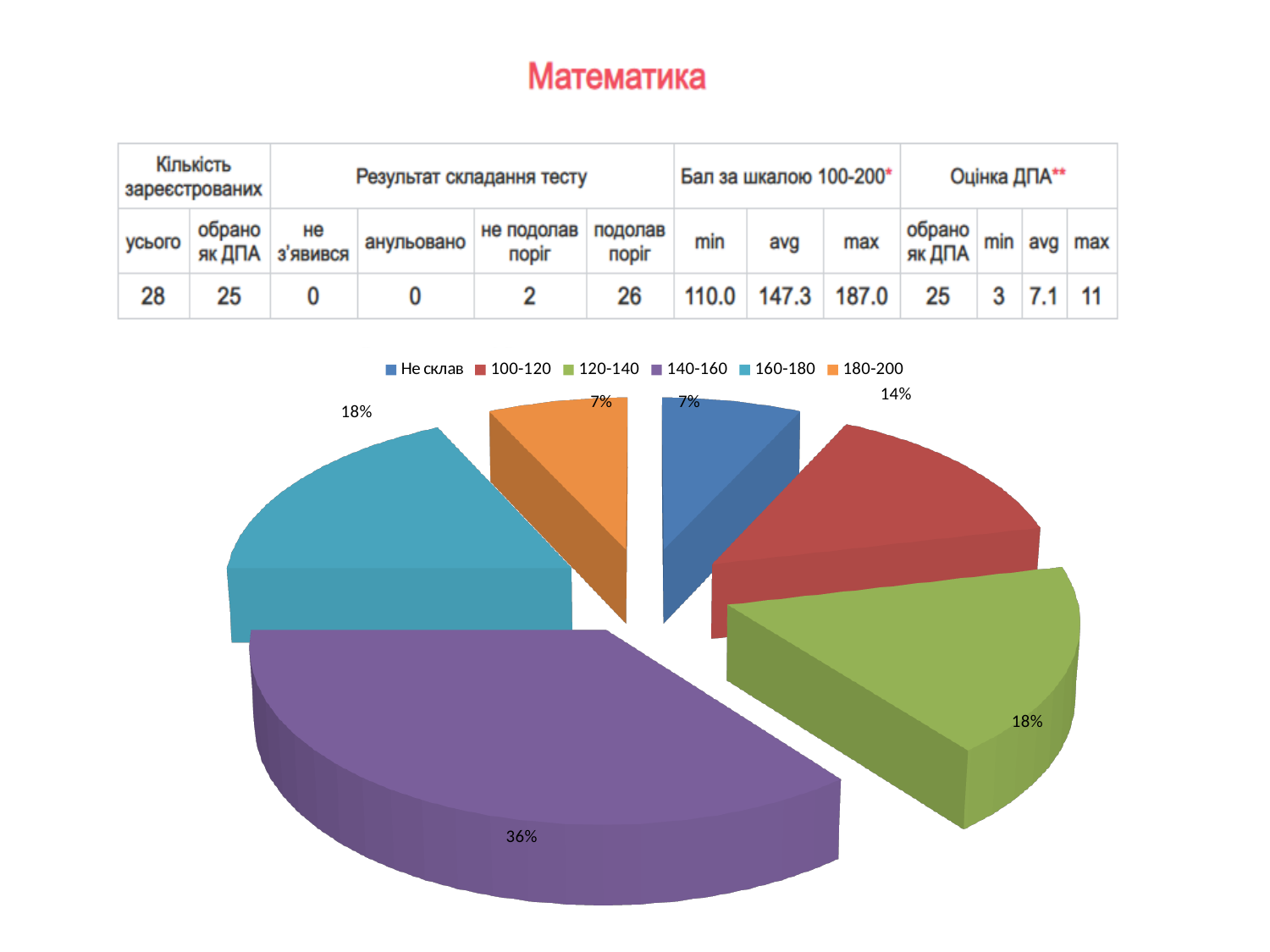
What percentage is shown for the 160-180 slice? 18% Which slice is larger, 100-120 or 140-160? 140-160 What percentage of the pie chart does the 140-160 slice represent? 36% What kind of chart is shown on the slide? Pie chart What colour is the 140-160 slice in the pie chart? Purple What percentage is shown for the 100-120 slice? 14% What is the difference in percentage points between the 140-160 slice and the 120-140 slice? 18 What percentage is shown for the 180-200 slice? 7% How many entries does the legend of the pie chart list? 6 Which category has the largest slice of the pie chart? 140-160 What percentage is shown for the 'Не склав' slice? 7% How many slices does the pie chart have? 6